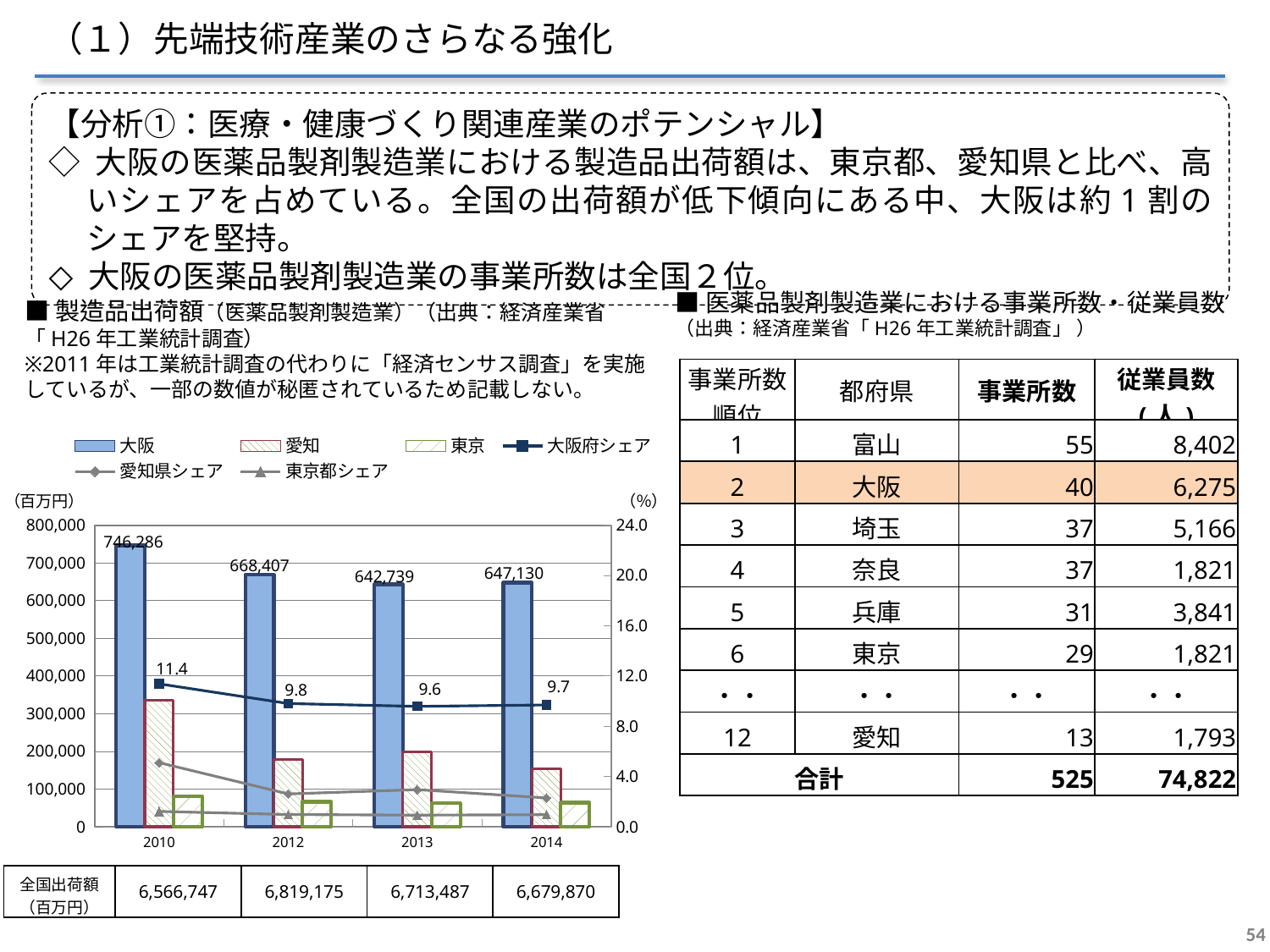
What is the difference between the 大阪 bar values for 2010 and 2012? 77,879 In which year is the 大阪 bar highest in the chart? 2010 What is the 大阪府シェア value for 2013 in the chart? 9.6 What is the value of the 大阪 bar for 2010 in the 製造品出荷額 chart? 746,286 How many years are shown on the x axis of the chart? 4 Is the 愛知 bar for 2010 greater or less than 300,000? greater What is the value of the 大阪 bar for 2014 in the 製造品出荷額 chart? 647,130 In which year is the 大阪 bar lowest in the chart? 2013 Does the 大阪府シェア line rise or fall from 2010 to 2013? fall Which is larger in the chart: the 大阪 bar for 2013 or the 大阪 bar for 2014? 2014 How many series does the chart legend list? 6 What is the 大阪府シェア value for 2012 in the chart? 9.8